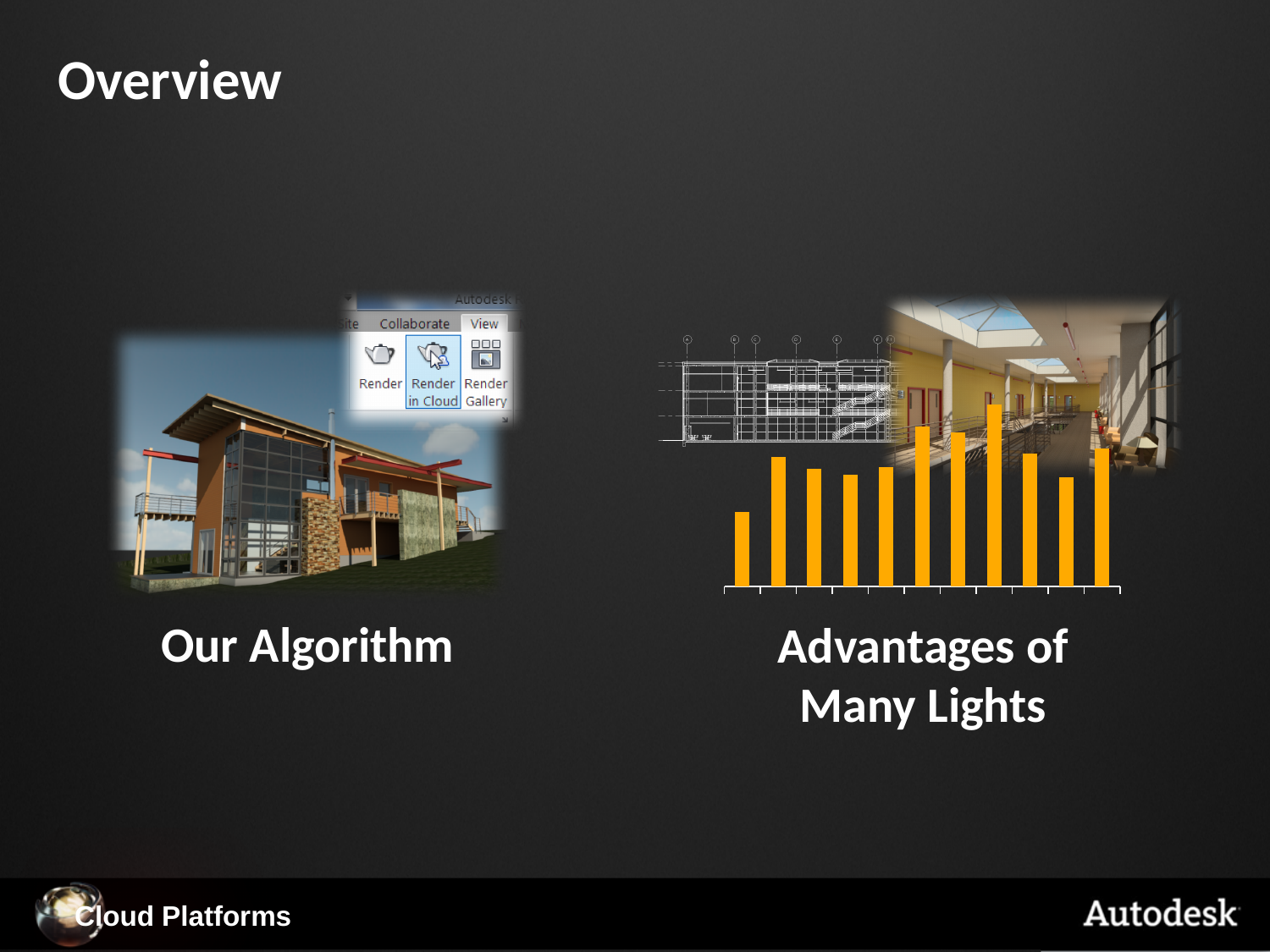
Does the bar chart on the right side of the slide display any axis labels or data labels? No In the bar chart on the right side of the slide, which bar, counting from the left, is the shortest? the first bar How many bars does the bar chart on the right side of the slide contain? 11 In the bar chart on the right side of the slide, which bar, counting from the left, is the tallest? the eighth bar What colour are the bars in the bar chart on the right side of the slide? orange In the bar chart on the right side of the slide, is the tenth bar from the left taller or shorter than the eleventh bar? shorter In the bar chart on the right side of the slide, is the first bar from the left taller or shorter than the second bar? shorter What kind of chart is shown on the right side of the slide, under the building interior image? bar chart